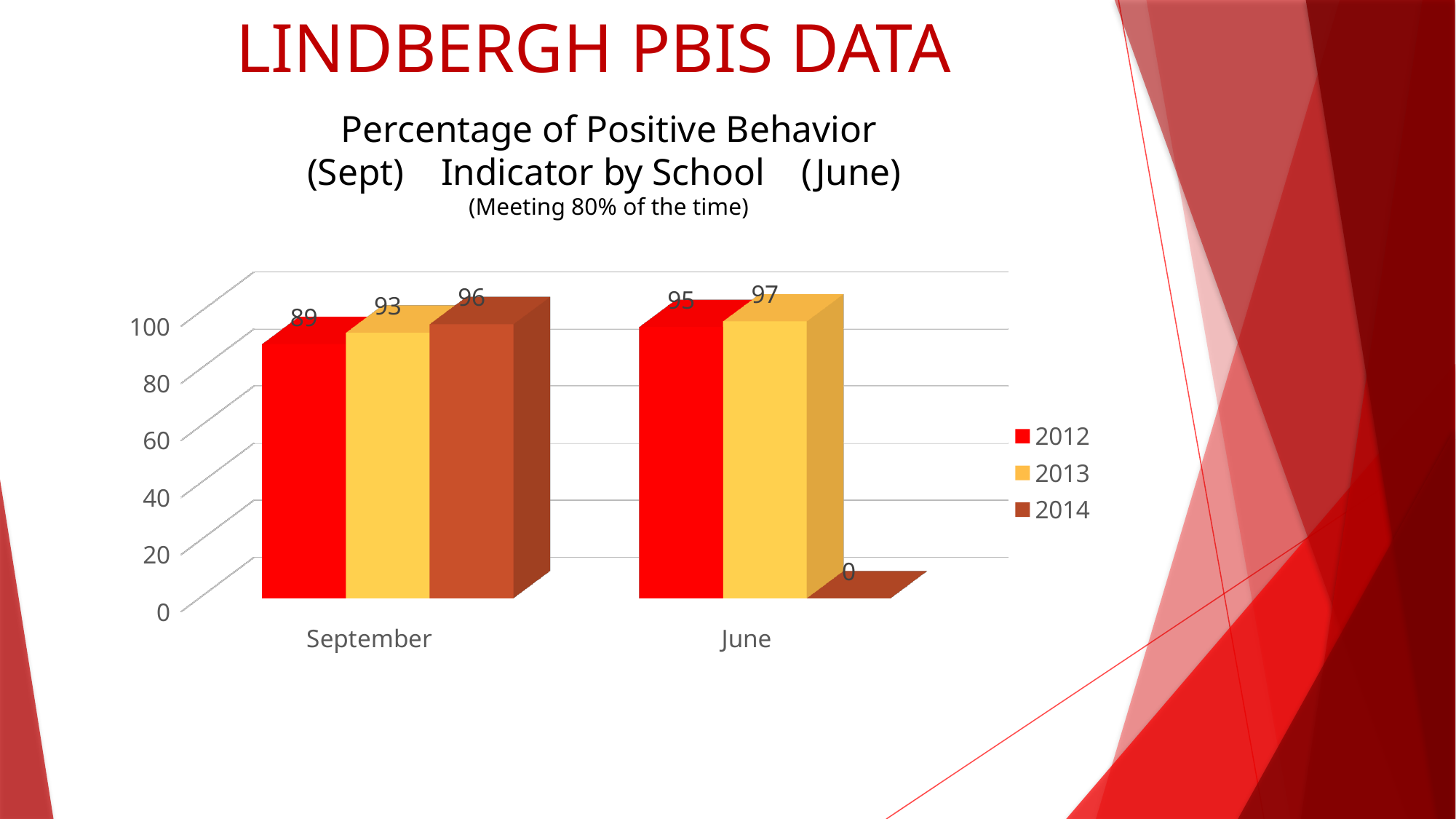
What is the value for 2013 in June? 97 Which year has the highest value in September? 2014 What kind of chart is shown on the slide? Bar chart What is the value for 2014 in September? 96 What is the value for 2012 in September? 89 How many series does the legend list? 3 What is the difference between the 2013 and 2012 values in September? 4 Which is larger, the 2012 value in September or the 2012 value in June? June Which year has the lowest value in June? 2014 What is the value for 2013 in September? 93 What is the value for 2014 in June? 0 What is the value for 2012 in June? 95